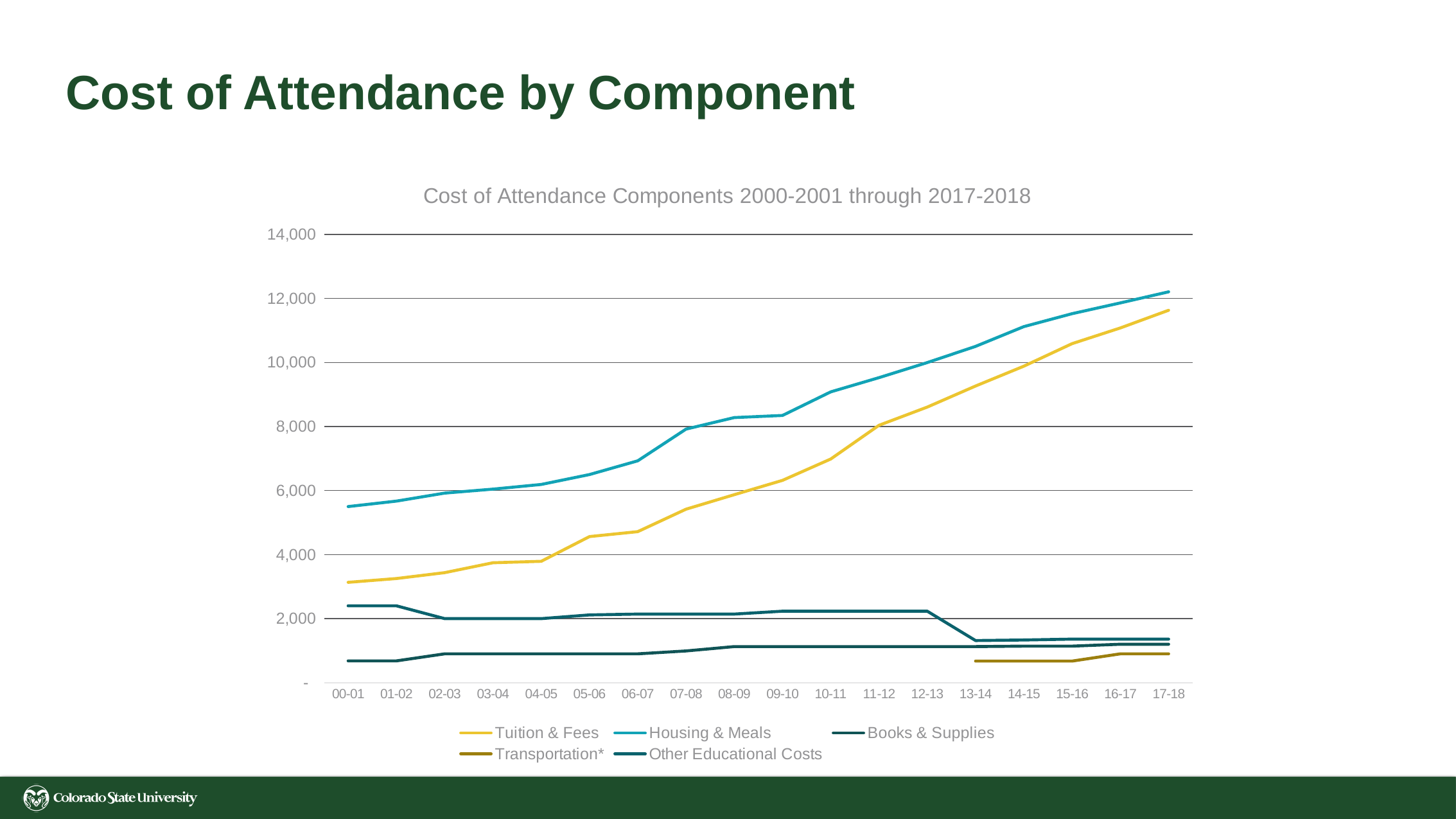
How many academic years are shown along the x axis? 18 Does the Tuition & Fees line rise or fall from 00-01 to 17-18? rise Is the value for Housing & Meals in 00-01 greater or less than 6,000? less Is the value for Tuition & Fees in 00-01 greater or less than 4,000? less What is the title of the chart? Cost of Attendance Components 2000-2001 through 2017-2018 In 10-11, which is larger: Housing & Meals or Tuition & Fees? Housing & Meals Which series has the lowest value in 00-01? Books & Supplies Is the value for Tuition & Fees in 17-18 greater or less than 10,000? greater What kind of chart is shown on the slide? line chart Which series has the highest value in 17-18? Housing & Meals How many series does the legend list? 5